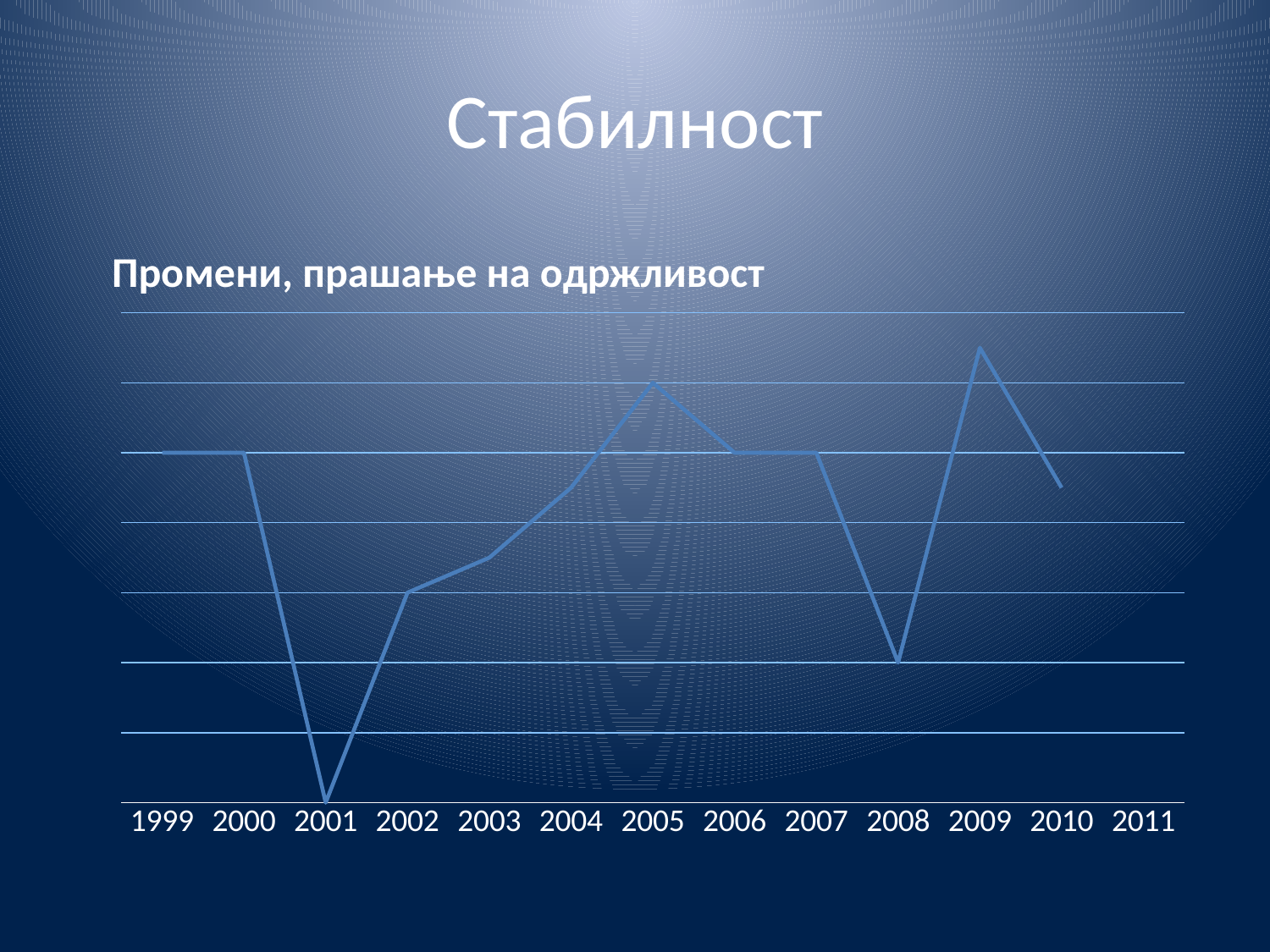
What is the first year shown on the x axis? 1999 Does the line rise or fall from 2009 to 2010? fall Which year has the higher value, 2001 or 2008? 2008 Which year has the higher value, 2005 or 2006? 2005 In which year does the line reach its lowest point? 2001 In which year does the line reach its highest point? 2009 What kind of chart is shown on the slide? line chart Which year has the higher value, 2005 or 2009? 2009 What is the title of the chart? Промени, прашање на одржливост Does the line rise or fall from 2001 to 2005? rise How many year labels are shown on the x axis? 13